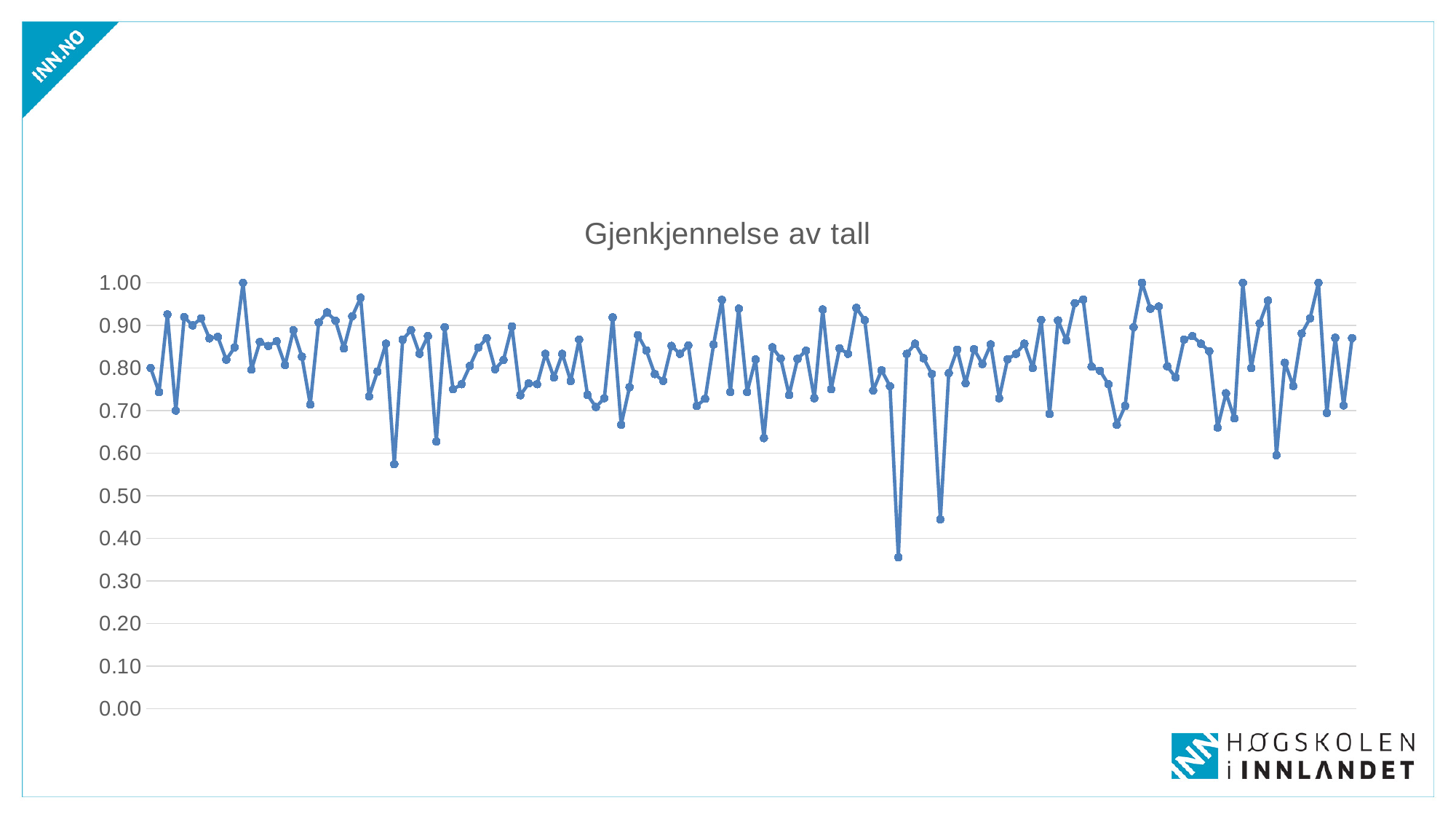
Is the lowest value on the line greater or less than 0.30? greater Do most of the plotted values lie above or below 0.70? above Is the last data point on the line greater or less than 0.80? greater What is the title of the chart? Gjenkjennelse av tall What is the highest value reached by the line in the chart? 1.00 What is the maximum value shown on the vertical axis? 1.00 What kind of chart is shown on the slide? line chart